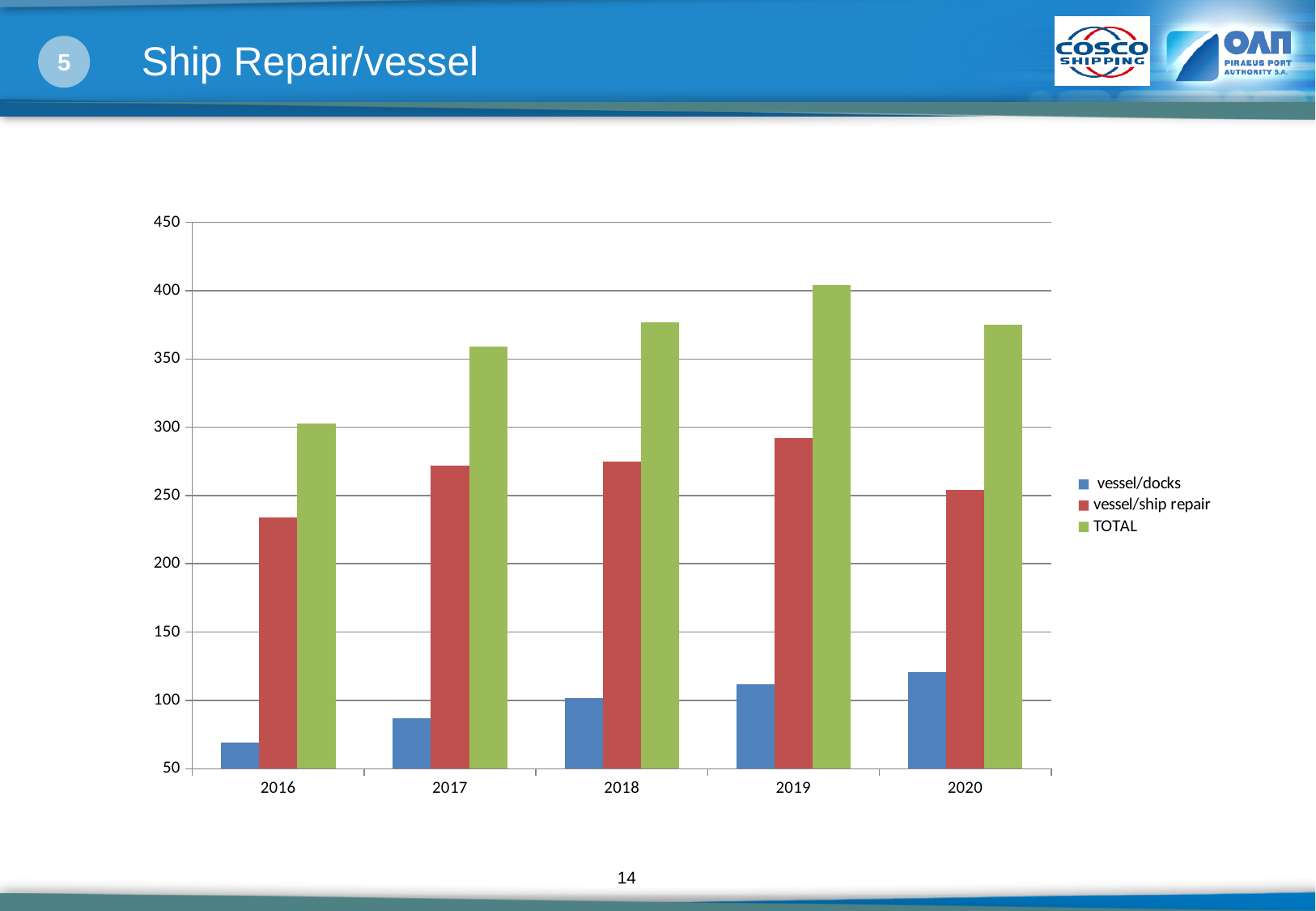
What kind of chart is shown on the slide? bar chart In which year is the vessel/ship repair bar lowest? 2016 How many series does the legend list? 3 Is the vessel/ship repair value for 2019 greater or less than 300? less Is the TOTAL value for 2017 greater or less than 350? greater Do the vessel/docks values rise or fall from 2016 to 2020? rise In which year is the TOTAL bar highest? 2019 Which is larger, the vessel/ship repair value for 2019 or for 2020? 2019 How many years are shown on the x axis? 5 In which year is the TOTAL bar lowest? 2016 In which year is the vessel/docks bar highest? 2020 Is the vessel/docks value for 2016 greater or less than 100? less